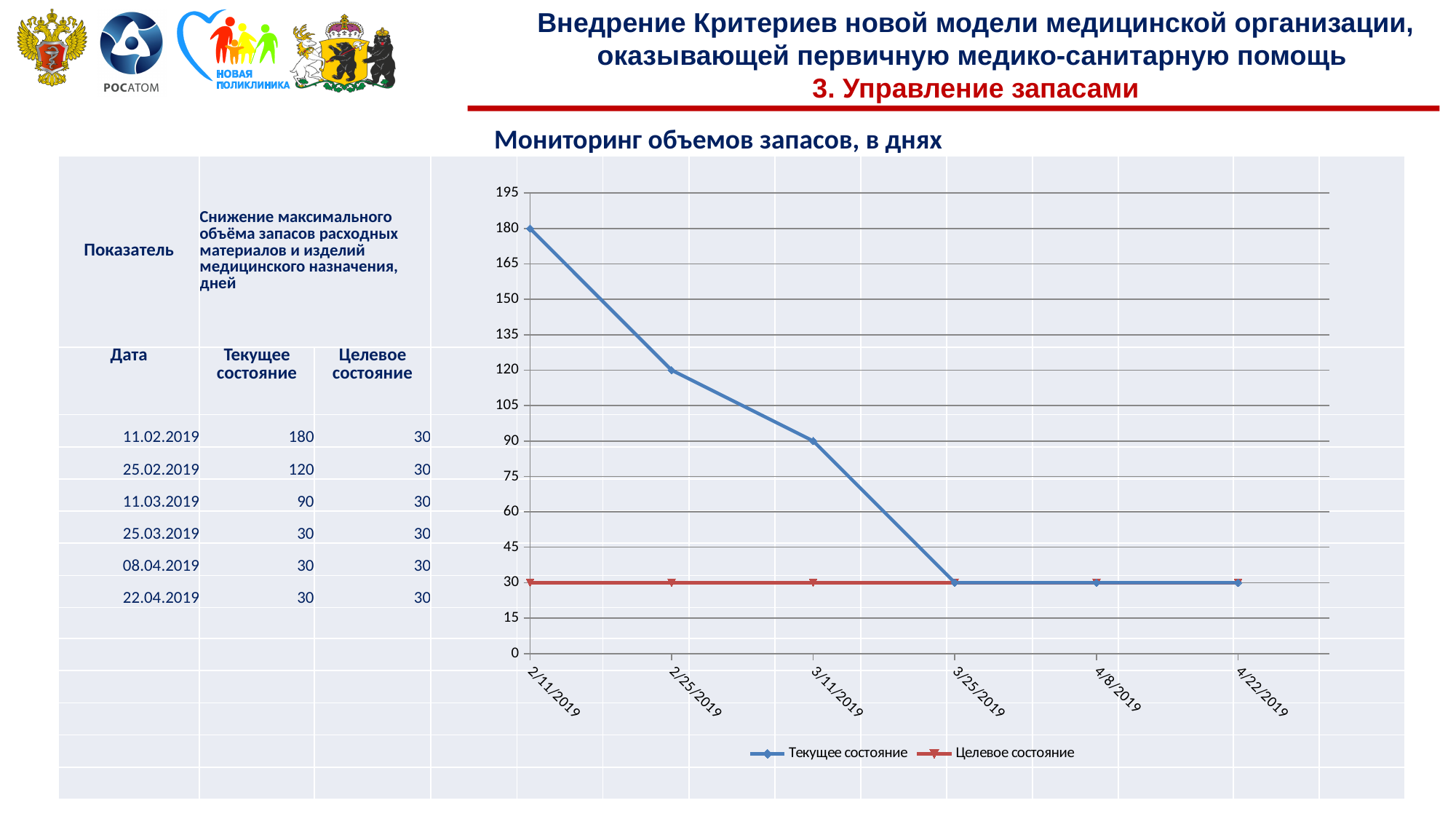
On which date is Текущее состояние at its highest? 2/11/2019 What is the title of the chart? Мониторинг объемов запасов, в днях How many dates are plotted along the x axis of the chart? 6 What is the value of Текущее состояние on 3/11/2019? 90 What is the value of Целевое состояние on 4/22/2019? 30 What is the value of Текущее состояние on 2/11/2019? 180 Which is larger on 3/11/2019: Текущее состояние or Целевое состояние? Текущее состояние Does Текущее состояние rise or fall from 2/11/2019 to 3/25/2019? fall What kind of chart is shown on the slide? line chart What is the difference between Текущее состояние on 2/11/2019 and on 2/25/2019? 60 What is the value of Текущее состояние on 2/25/2019? 120 How many series does the chart legend list? 2